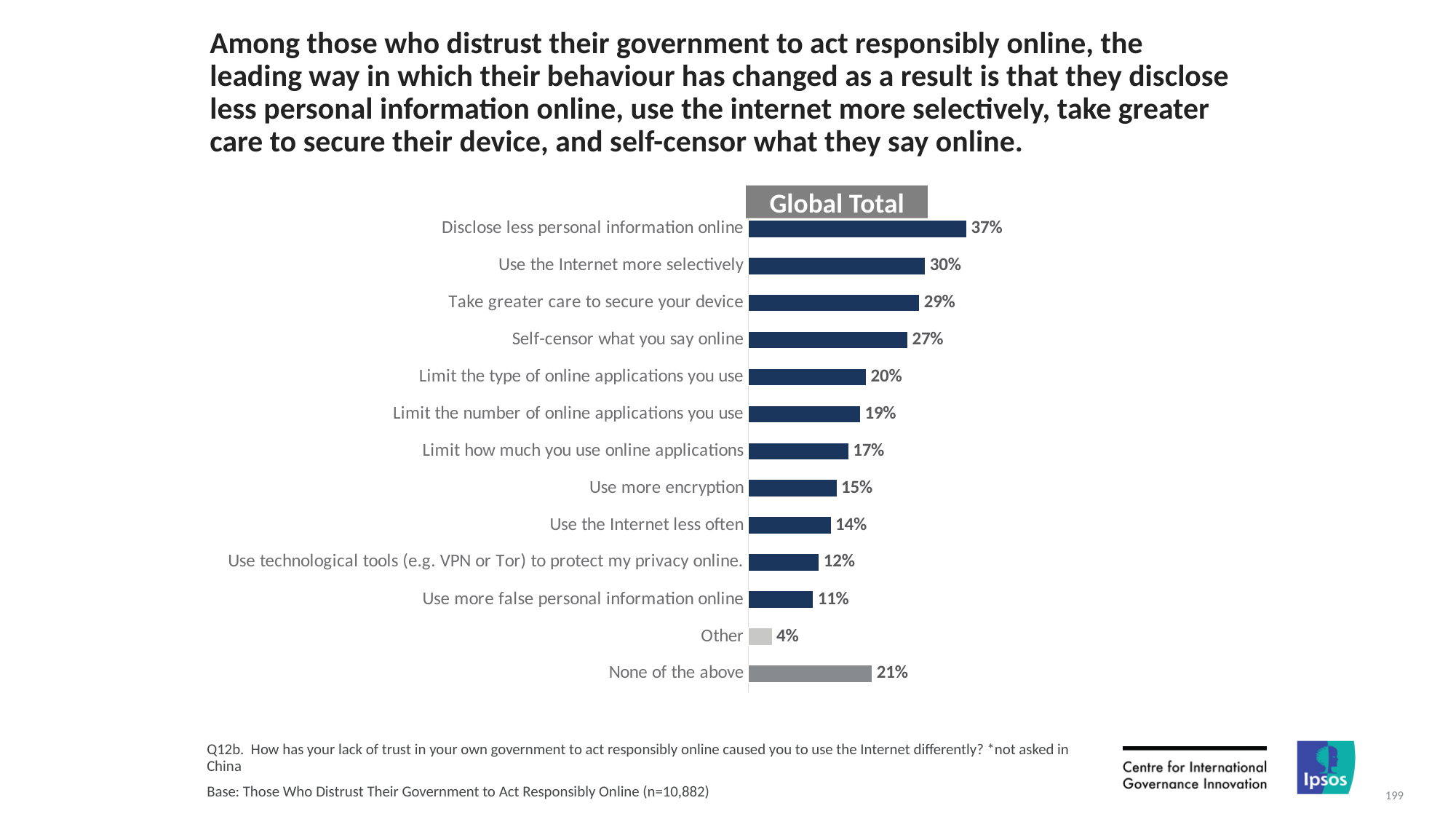
What percentage of respondents say they disclose less personal information online? 37% What is the value for "Use technological tools (e.g. VPN or Tor) to protect my privacy online."? 12% What is the value for "Use more encryption"? 15% What is the difference between "Use the Internet more selectively" and "Self-censor what you say online"? 3% Which category has the lowest value? Other Which category has the highest value? Disclose less personal information online What is the difference between "Disclose less personal information online" and "None of the above"? 16% What is the value for "None of the above"? 21% How many categories are shown in the chart? 13 What is the title shown above the chart? Global Total Which is larger: "Limit the type of online applications you use" or "Use the Internet less often"? Limit the type of online applications you use What kind of chart is shown on the slide? Bar chart